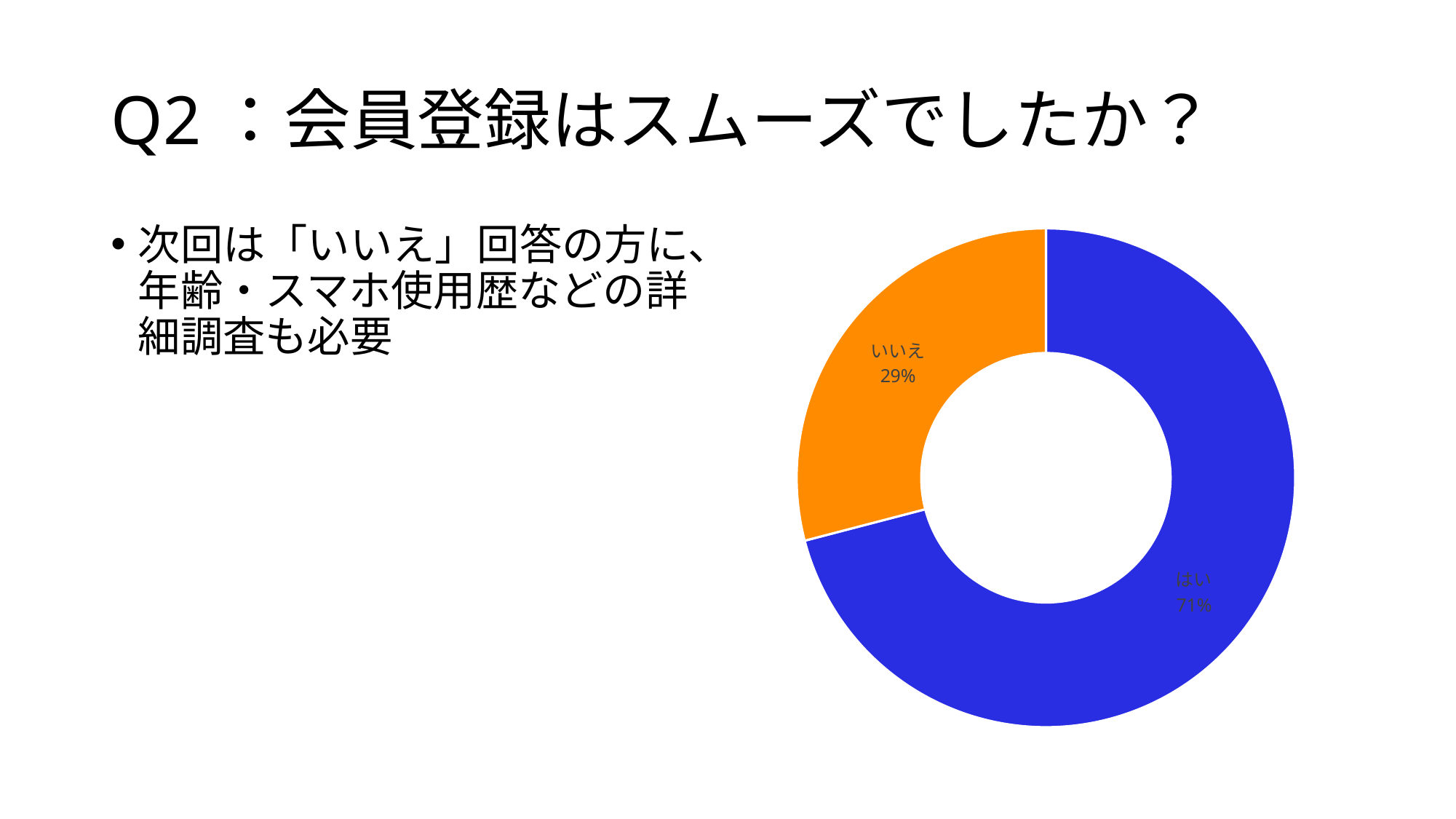
Which category has the smallest slice in the chart? いいえ What share of the doughnut chart does the いいえ slice represent? 29% What share of the doughnut chart does the はい slice represent? 71% Which slice is larger, はい or いいえ? はい Which category has the largest slice in the chart? はい How many categories are shown in the chart? 2 What colour is the いいえ slice? orange What kind of chart is shown on the slide? doughnut chart What is the difference in percentage points between the はい and いいえ slices? 42 What colour is the はい slice? blue